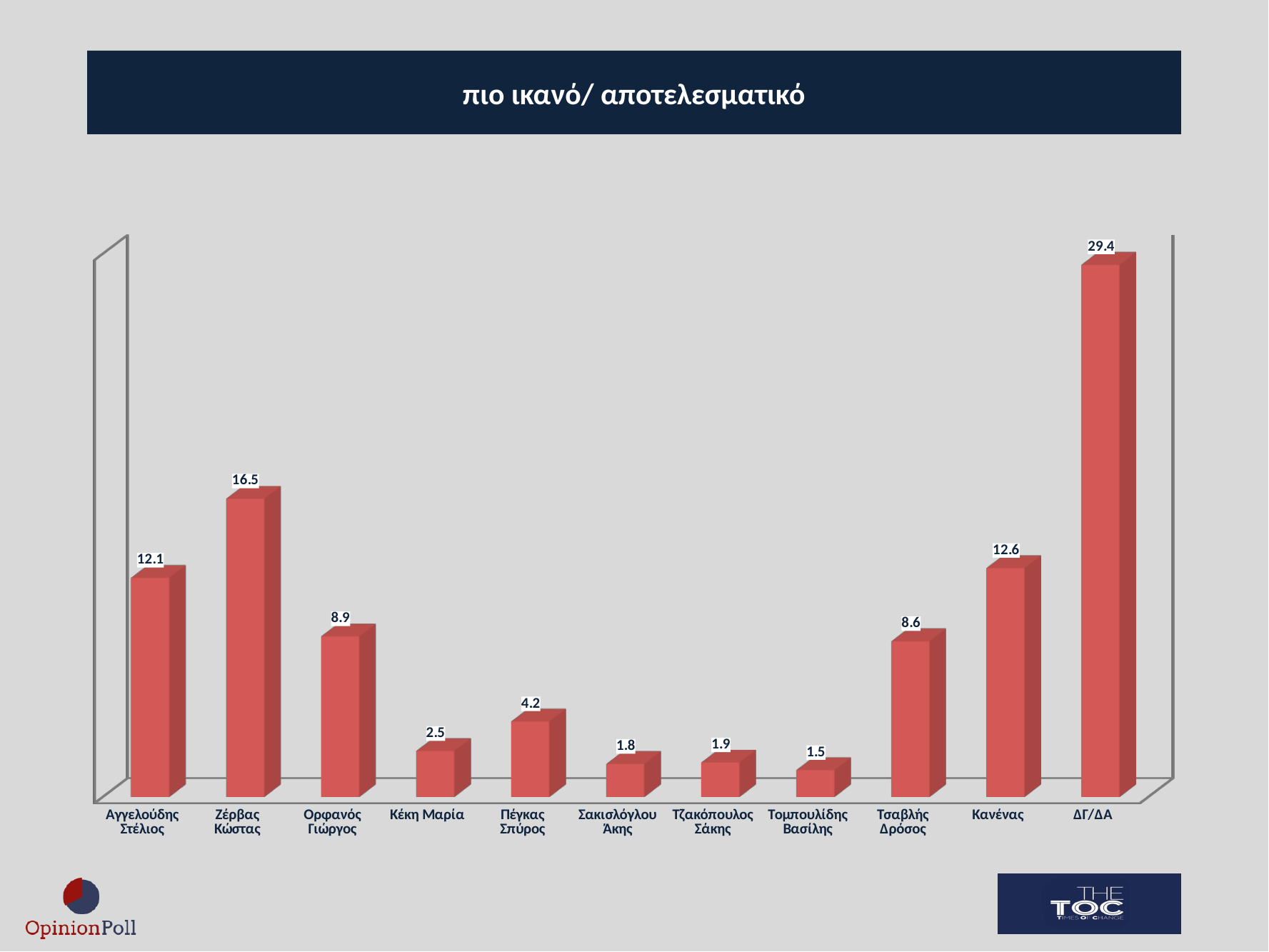
What is the value for Τσαβλής Δρόσος? 8.6 What is the title of the chart? πιο ικανό/ αποτελεσματικό What is the difference between the values for Ζέρβας Κώστας and Αγγελούδης Στέλιος? 4.4 What is the value for Κανένας? 12.6 Which category has the highest value? ΔΓ/ΔΑ Which category has the lowest value? Τομπουλίδης Βασίλης What is the value for ΔΓ/ΔΑ? 29.4 How many categories are shown on the x axis? 11 What is the value for Ζέρβας Κώστας? 16.5 Which is larger, the value for Ορφανός Γιώργος or the value for Τσαβλής Δρόσος? Ορφανός Γιώργος What kind of chart is shown on the slide? bar chart Which is larger, the value for Κανένας or the value for Αγγελούδης Στέλιος? Κανένας